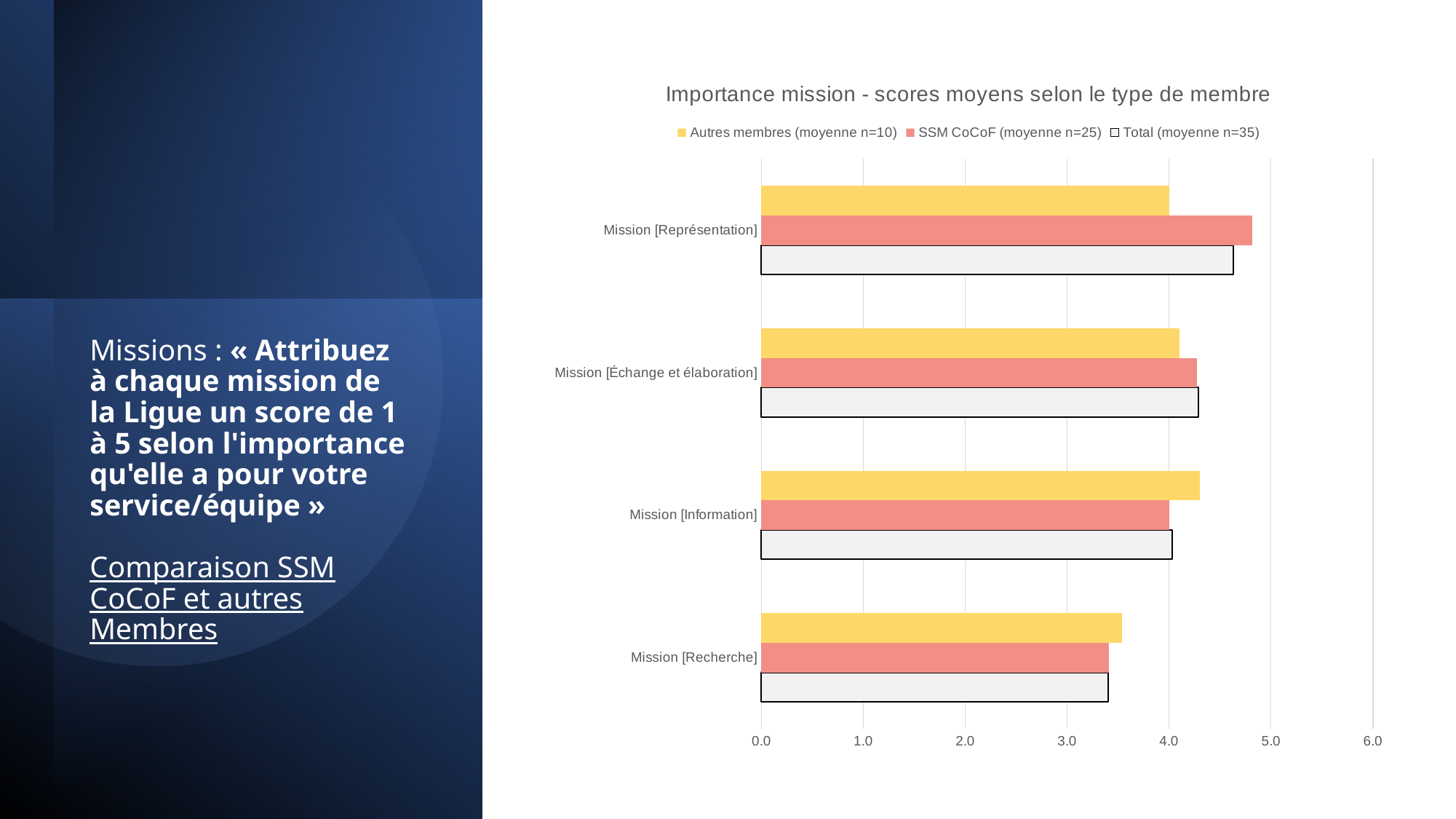
Is the Autres membres (moyenne n=10) score for Mission [Recherche] greater or less than 4.0? less For Mission [Représentation], which series has the larger score: Autres membres (moyenne n=10) or SSM CoCoF (moyenne n=25)? SSM CoCoF (moyenne n=25) Is the Total (moyenne n=35) score for Mission [Représentation] greater or less than 4.0? greater Which mission has the highest score for SSM CoCoF (moyenne n=25)? Mission [Représentation] How many series does the legend of the chart list? 3 What kind of chart is shown on the slide? bar chart How many missions (categories) are plotted on the chart? 4 What is the title of the chart? Importance mission - scores moyens selon le type de membre Which mission has the lowest score for Total (moyenne n=35)? Mission [Recherche] Is the SSM CoCoF (moyenne n=25) score for Mission [Représentation] greater or less than 4.0? greater For Mission [Information], which series has the larger score: Autres membres (moyenne n=10) or SSM CoCoF (moyenne n=25)? Autres membres (moyenne n=10)